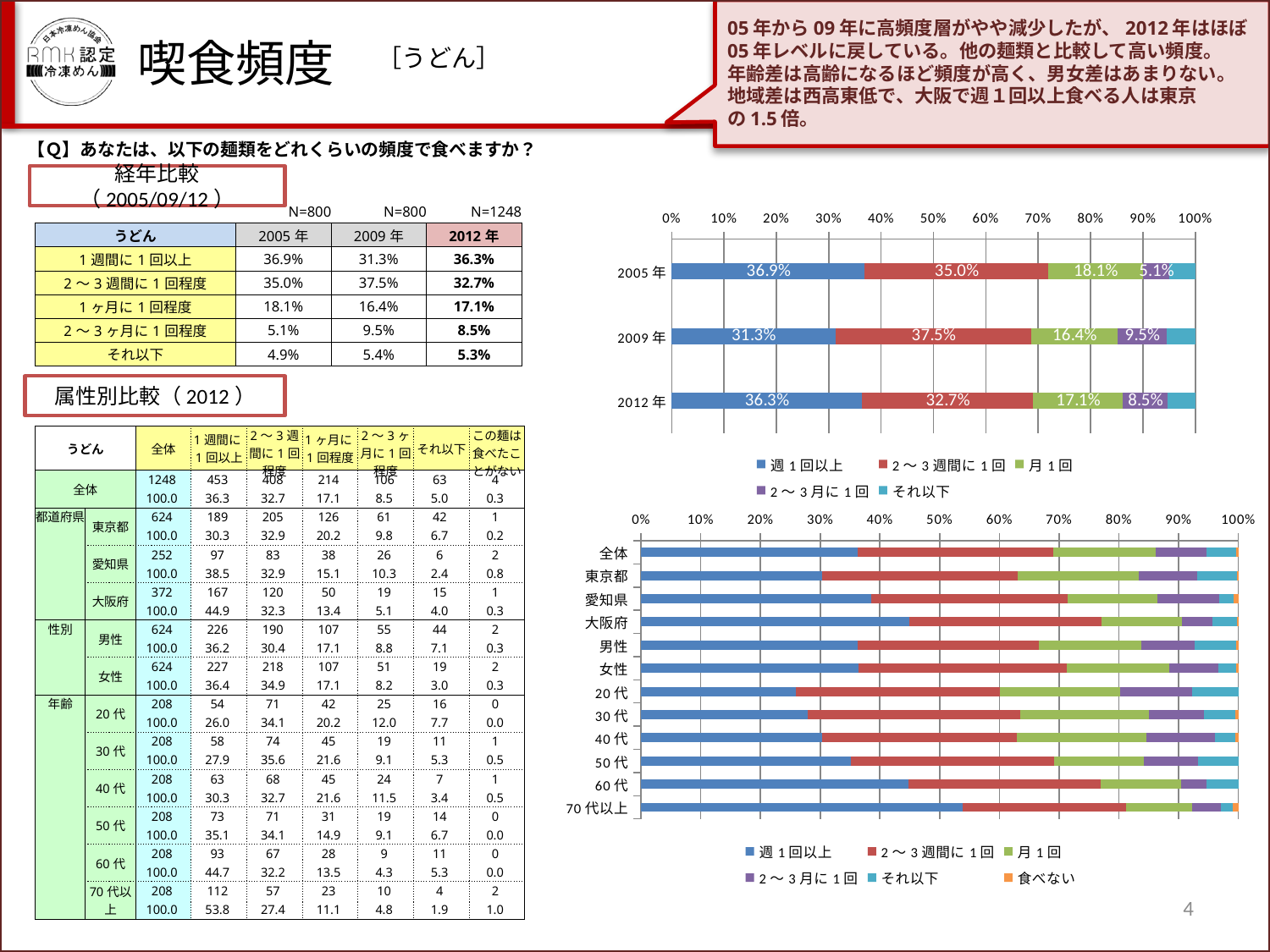
What type of chart is the bottom-right chart? Stacked bar chart In the top-right chart, what is the difference between the 週1回以上 values for 2005年 and 2009年? 5.6 percentage points In the top-right chart, what is the value of 2～3週間に1回 for 2009年? 37.5% In the top-right chart, for 2012年, which is larger: 週1回以上 or 2～3週間に1回? 週1回以上 In the bottom-right chart, is the 週1回以上 value for 70代以上 greater or less than 50%? greater In the top-right chart, what is the value of 2～3月に1回 for 2012年? 8.5% In the top-right chart, which year has the lowest value for 週1回以上? 2009年 In the bottom-right chart, is the 週1回以上 value for 20代 greater or less than 30%? less How many series does the legend of the top-right chart list? 5 In the top-right chart (経年比較), what is the value of 週1回以上 for 2005年? 36.9% How many categories are shown on the vertical axis of the bottom-right chart? 12 In the top-right chart, which year has the highest value for 2～3週間に1回? 2009年